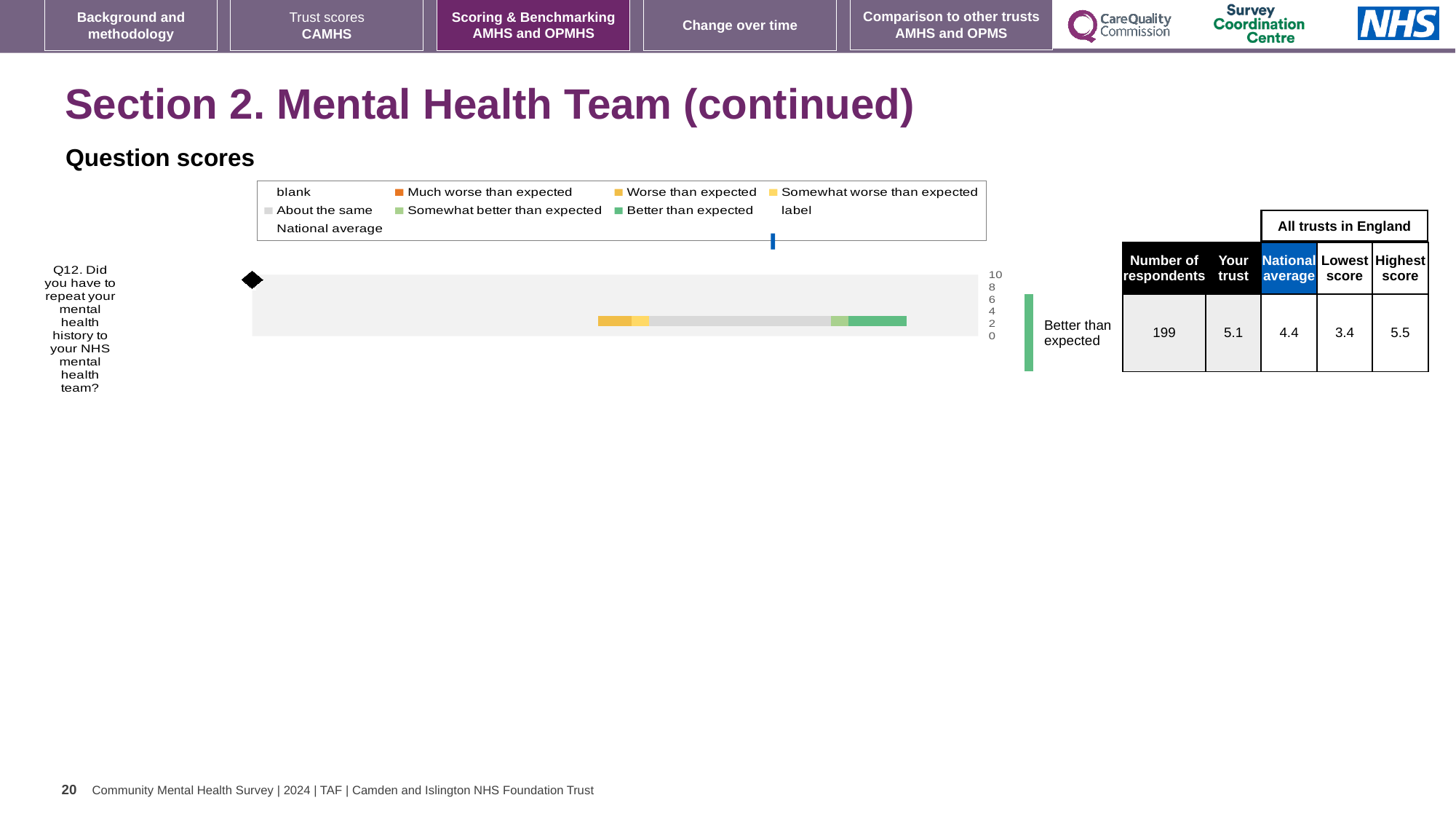
How many questions are plotted on the chart? 1 For Q12, which is higher: the 'Your trust' score or the national average? Your trust What is the difference between the 'Your trust' score and the national average for Q12? 0.7 Which question is plotted on the chart? Q12. Did you have to repeat your mental health history to your NHS mental health team? What benchmark category is shown to the right of the Q12 bar? Better than expected What is the highest score among all trusts in England for Q12? 5.5 What kind of chart is used to show the Q12 question score? Bar chart What is the lowest score among all trusts in England for Q12? 3.4 How many respondents answered Q12? 199 What is the difference between the highest and lowest scores for Q12 across all trusts in England? 2.1 What is the 'Your trust' score for Q12? 5.1 What is the national average score for Q12? 4.4